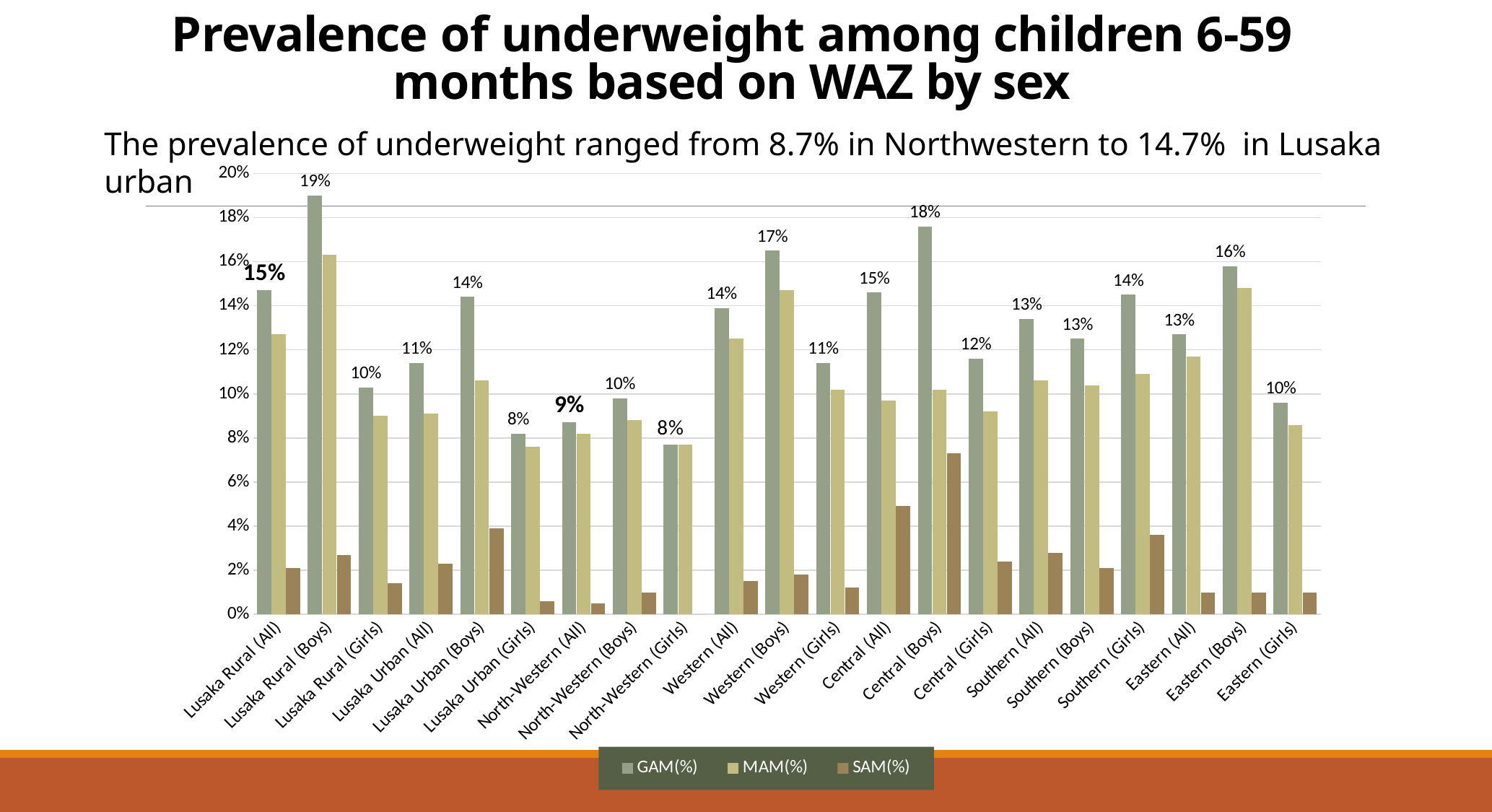
Is the SAM(%) value for Central (Boys) greater or less than 6%? greater What is the difference between the GAM(%) values for Lusaka Rural (Boys) and Lusaka Rural (Girls)? 9 percentage points What is the GAM(%) value for Lusaka Rural (Boys)? 19% What kind of chart is shown on the slide? Bar chart What is the GAM(%) value for Eastern (Girls)? 10% Which has a higher GAM(%) value, Western (Boys) or Central (Boys)? Central (Boys) What is the GAM(%) value for North-Western (All)? 9% Which category has the highest GAM(%) value? Lusaka Rural (Boys) What is the GAM(%) value for Central (Boys)? 18% Is the MAM(%) value for Lusaka Rural (Boys) greater or less than 14%? greater How many series does the legend list? 3 How many categories are shown on the x axis of the chart? 21